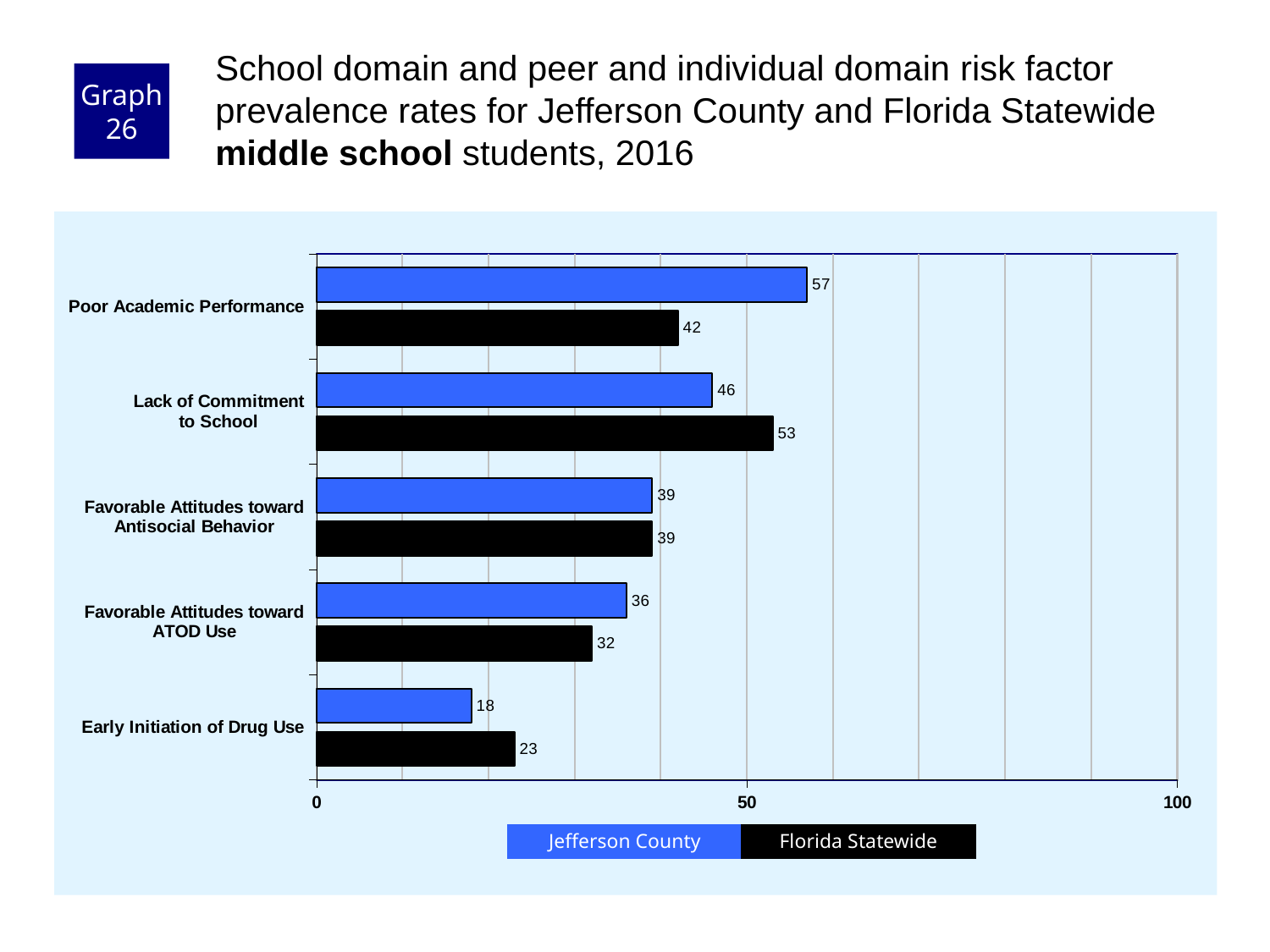
How many risk factors are shown on the chart? 5 Is the Jefferson County value for Favorable Attitudes toward ATOD Use greater or less than 50? less For Lack of Commitment to School, which is larger: the Jefferson County value or the Florida Statewide value? Florida Statewide What is the Jefferson County value for Poor Academic Performance? 57 Which risk factor has the lowest Florida Statewide value? Early Initiation of Drug Use What is the Florida Statewide value for Lack of Commitment to School? 53 What is the difference between the Jefferson County and Florida Statewide values for Poor Academic Performance? 15 How many series does the legend list? 2 Which colour represents Florida Statewide in the chart? black Which risk factor has the highest Jefferson County value? Poor Academic Performance What is the Jefferson County value for Early Initiation of Drug Use? 18 What kind of chart is shown on the slide? bar chart